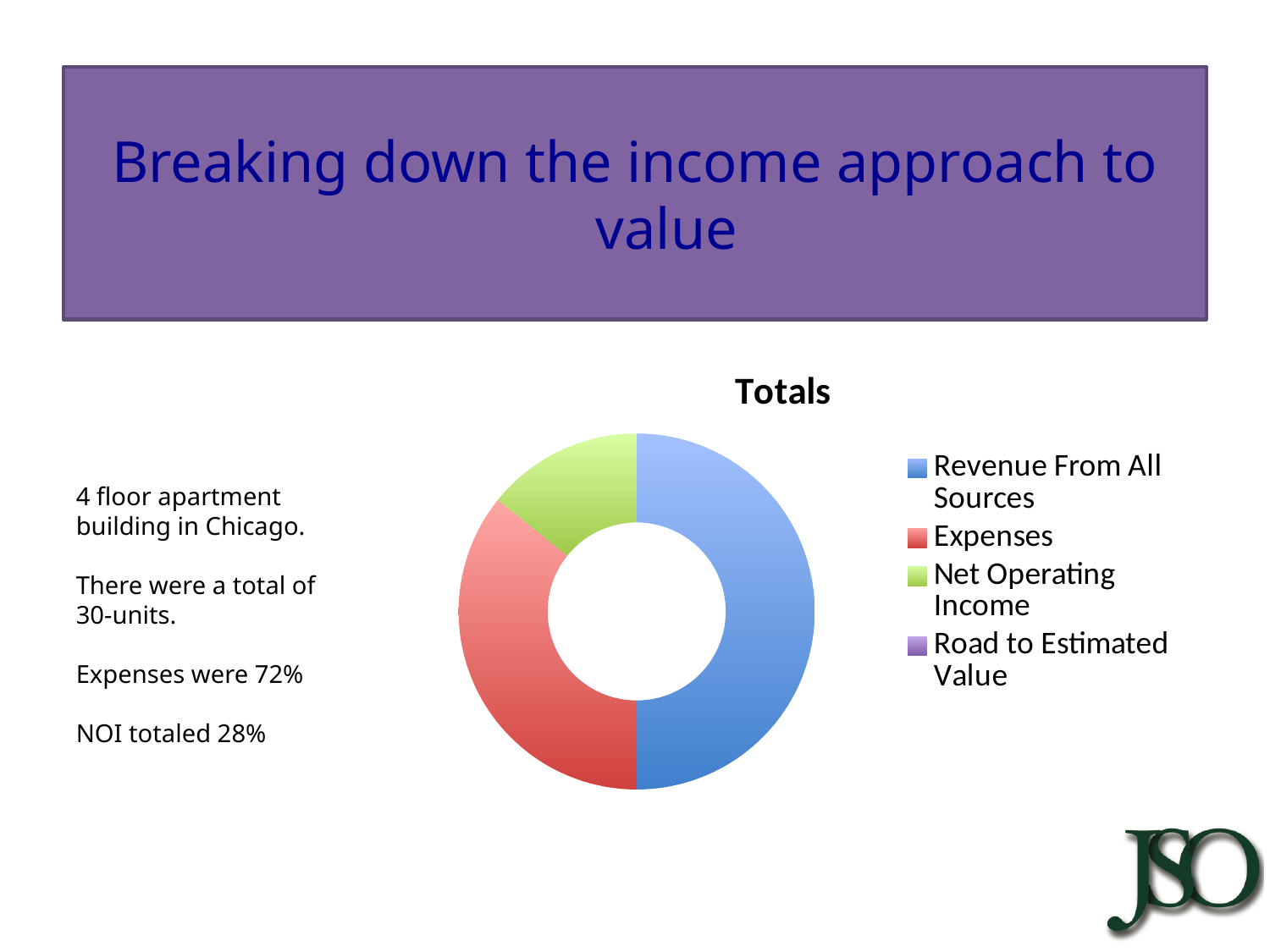
Which category has the largest slice in the chart? Revenue From All Sources Of the slices visible in the chart, which category has the smallest slice? Net Operating Income Which is larger in the chart, the slice for Expenses or the slice for Net Operating Income? Expenses Which is larger in the chart, the slice for Revenue From All Sources or the slice for Expenses? Revenue From All Sources What kind of chart is shown on the slide? doughnut chart What is the title of the chart? Totals How many slices are visible in the chart? 3 What colour is the Expenses slice in the chart? red How many entries does the chart's legend list? 4